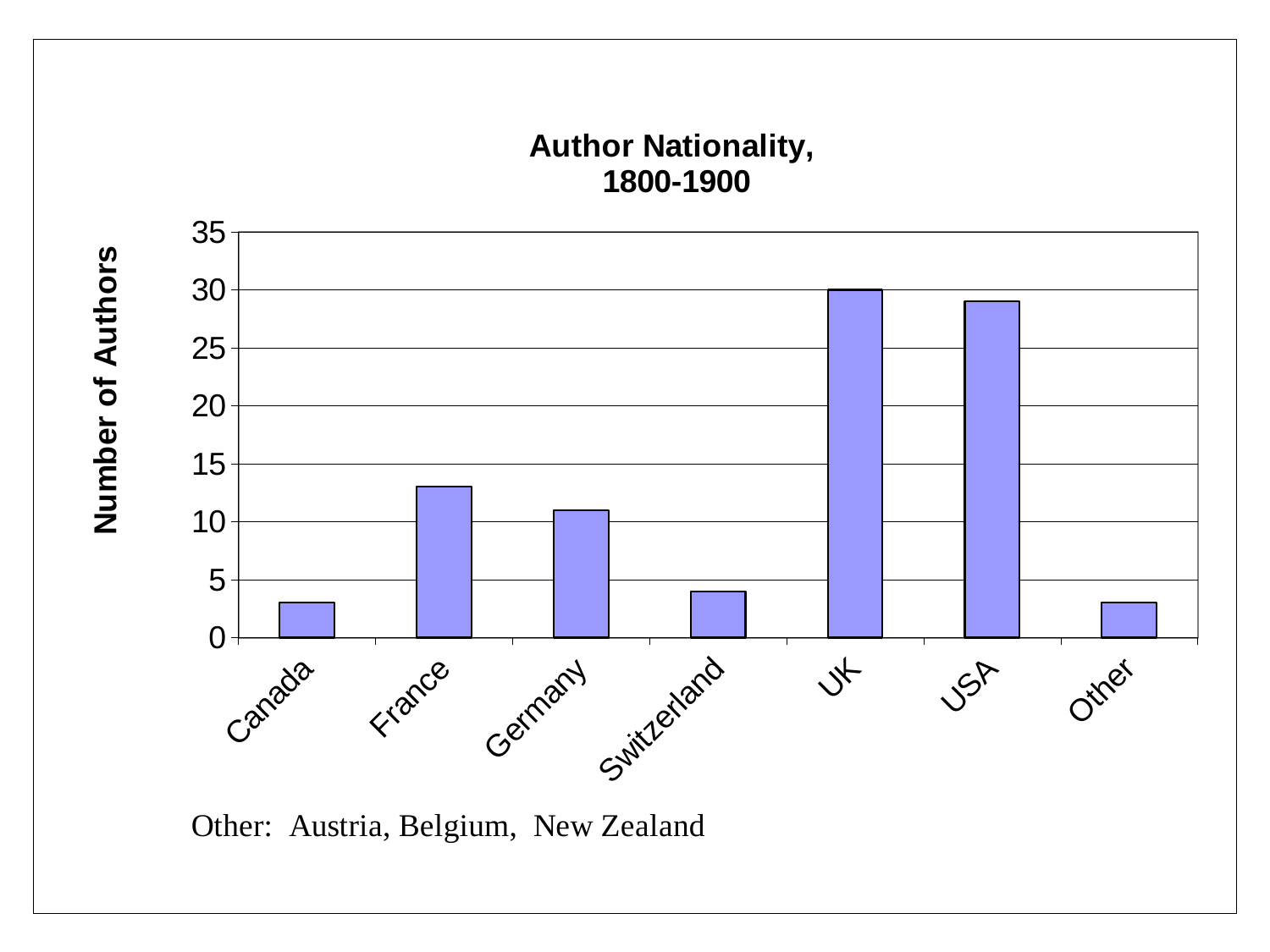
Which nationality has the highest number of authors? UK Is the number of authors for Switzerland greater or less than 5? less Which has more authors, France or Germany? France What is the title of the chart? Author Nationality, 1800-1900 What is the number of authors for the UK? 30 How many nationality categories are shown on the x axis? 7 Is the number of authors for Germany greater or less than 15? less Is the number of authors for France greater or less than 10? greater What type of chart is shown on the slide? bar chart What is the label on the vertical axis of the chart? Number of Authors Which has more authors, the UK or the USA? UK